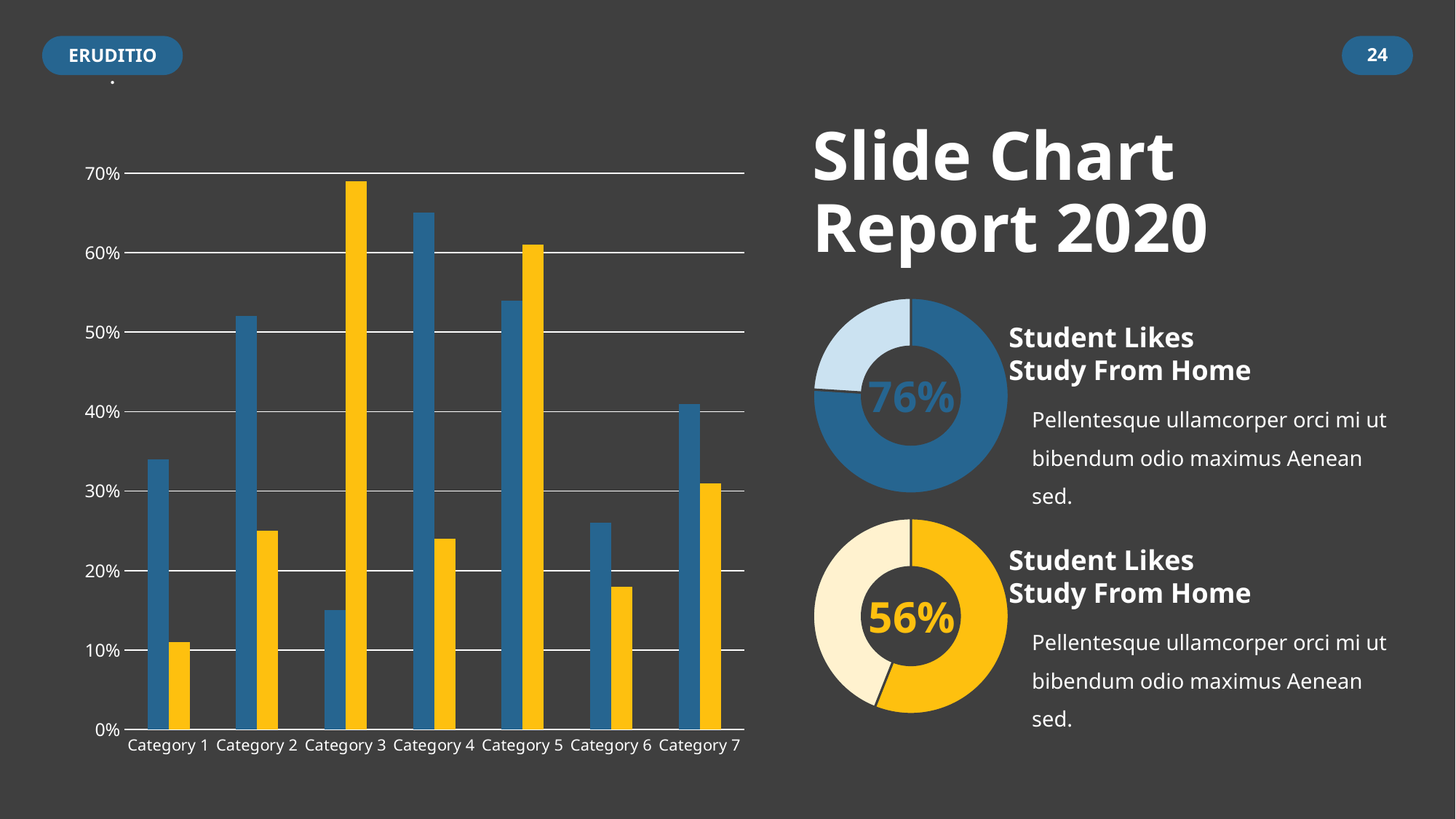
In the bar chart, which category has the shortest yellow bar? Category 1 How many categories are shown on the x axis of the bar chart? 7 In the bar chart, which category has the shortest blue bar? Category 3 In the bar chart, which category has the tallest blue bar? Category 4 What kind of chart is shown on the left of the slide? bar chart In the bar chart, which category has the tallest yellow bar? Category 3 In the bar chart, is the blue bar for Category 2 greater or less than 50%? greater What percentage is shown in the centre of the yellow donut chart? 56% In the bar chart, is the yellow bar for Category 6 greater or less than 20%? less In the bar chart, which is larger for Category 5: the blue bar or the yellow bar? the yellow bar What percentage is shown in the centre of the blue donut chart? 76%